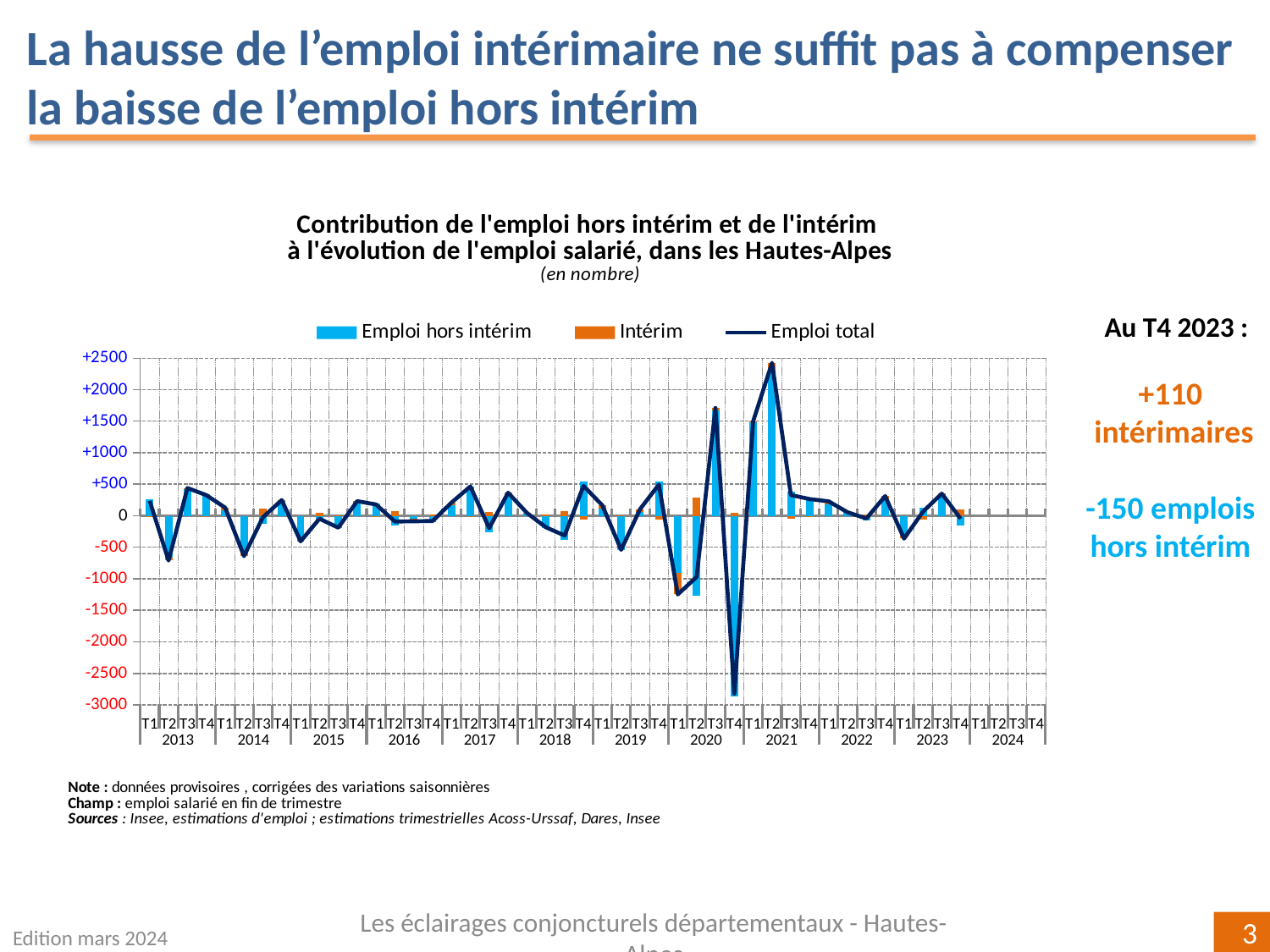
Which is larger for Emploi total: T3 2020 or T1 2021? T3 2020 Is the value of Emploi total at T4 2020 greater or less than -2500? less How many series does the chart legend list? 3 In which quarter does Emploi total reach its lowest value? T4 2020 How many years are labelled along the x axis of the chart? 12 What kind of chart is shown on the slide? A combined bar and line chart What colour are the Intérim bars in the chart? Orange In which quarter does Emploi total reach its highest value? T2 2021 Is the value of Emploi total at T3 2020 greater or less than +1000? greater Is the value of Emploi total at T1 2021 greater or less than +2000? less According to the slide, what is the value for Emploi hors intérim at T4 2023? -150 According to the slide, what is the value for Intérim at T4 2023? +110